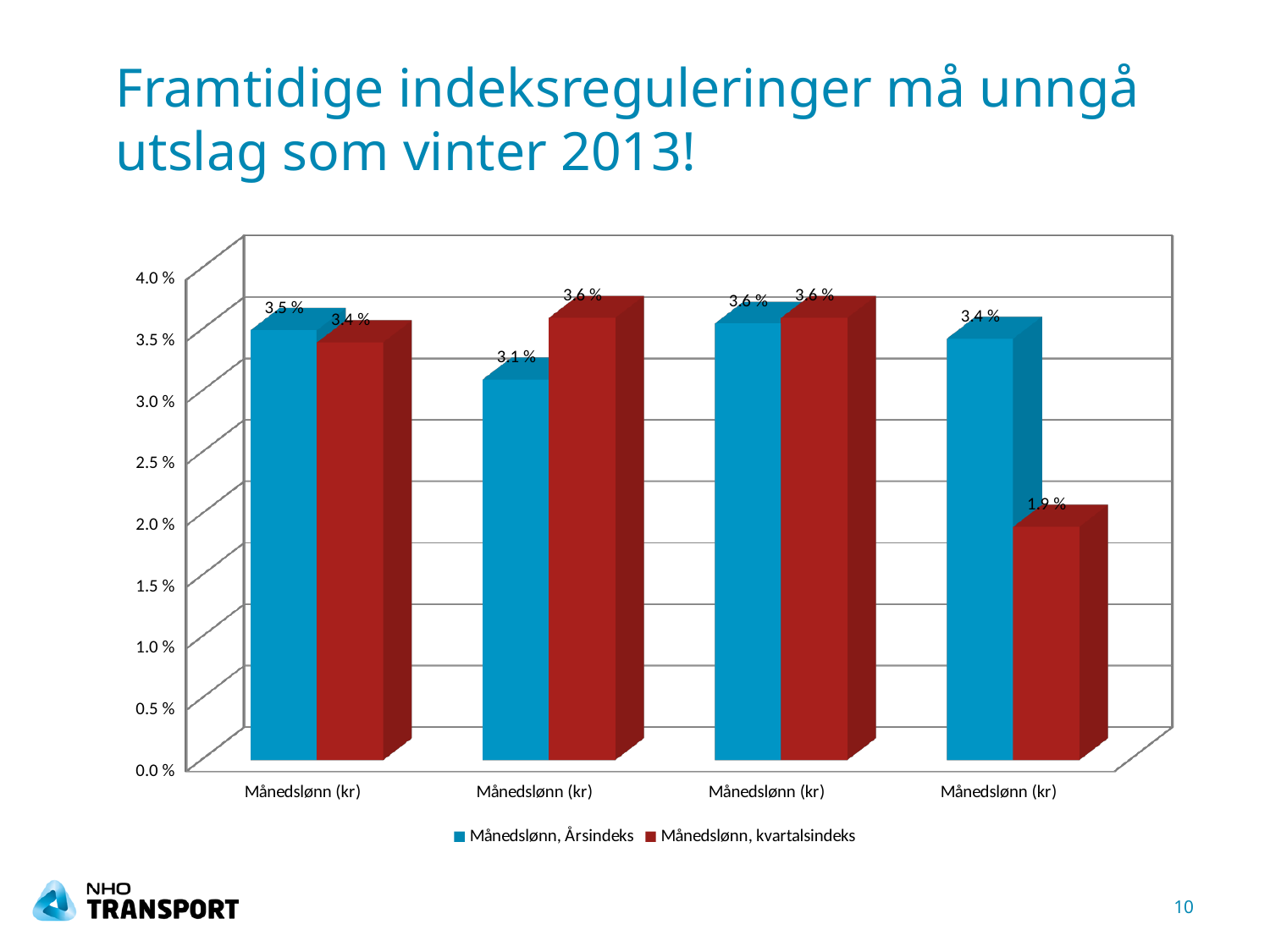
What is the value of the Månedslønn, Årsindeks series for the first (leftmost) category group? 3.5 % What is the value of the Månedslønn, kvartalsindeks series for the fourth (rightmost) category group? 1.9 % What is the value of the Månedslønn, kvartalsindeks series for the second category group from the left? 3.6 % Which series has the lowest value shown on the chart, and in which category group? Månedslønn, kvartalsindeks, fourth (rightmost) group Which colour represents the Månedslønn, kvartalsindeks series? Red What kind of chart is shown on the slide? Bar chart How many series does the legend list? 2 In the second category group from the left, which series has the larger value: Månedslønn, Årsindeks or Månedslønn, kvartalsindeks? Månedslønn, kvartalsindeks How many category groups are shown on the x axis? 4 What is the difference between the Månedslønn, Årsindeks and Månedslønn, kvartalsindeks values in the fourth (rightmost) category group? 1.5 % Is the Månedslønn, kvartalsindeks value in the fourth (rightmost) category group greater or less than 2.0 %? less What is the value of the Månedslønn, Årsindeks series for the second category group from the left? 3.1 %